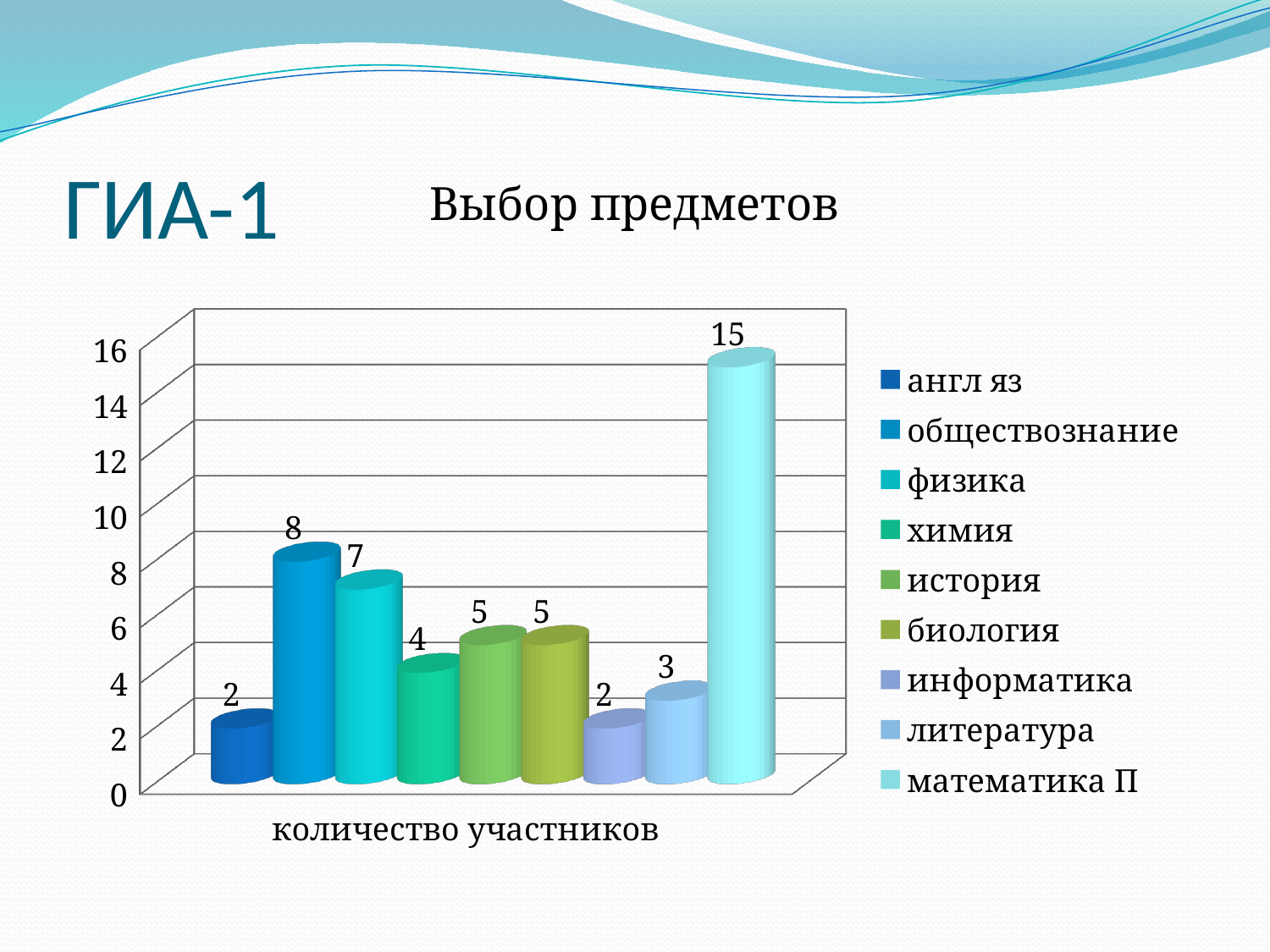
What is the value for обществознание? 8 Which is larger, the value for история or the value for литература? история What is the difference between the values for математика П and обществознание? 7 Is the value for математика П greater or less than 10? greater Which subject has the highest value? математика П What is the value for математика П? 15 What is the difference between the values for физика and химия? 3 What is the value for литература? 3 How many series does the legend list? 9 What kind of chart is shown on the slide? bar chart What is the title of the chart? Выбор предметов What is the value for физика? 7